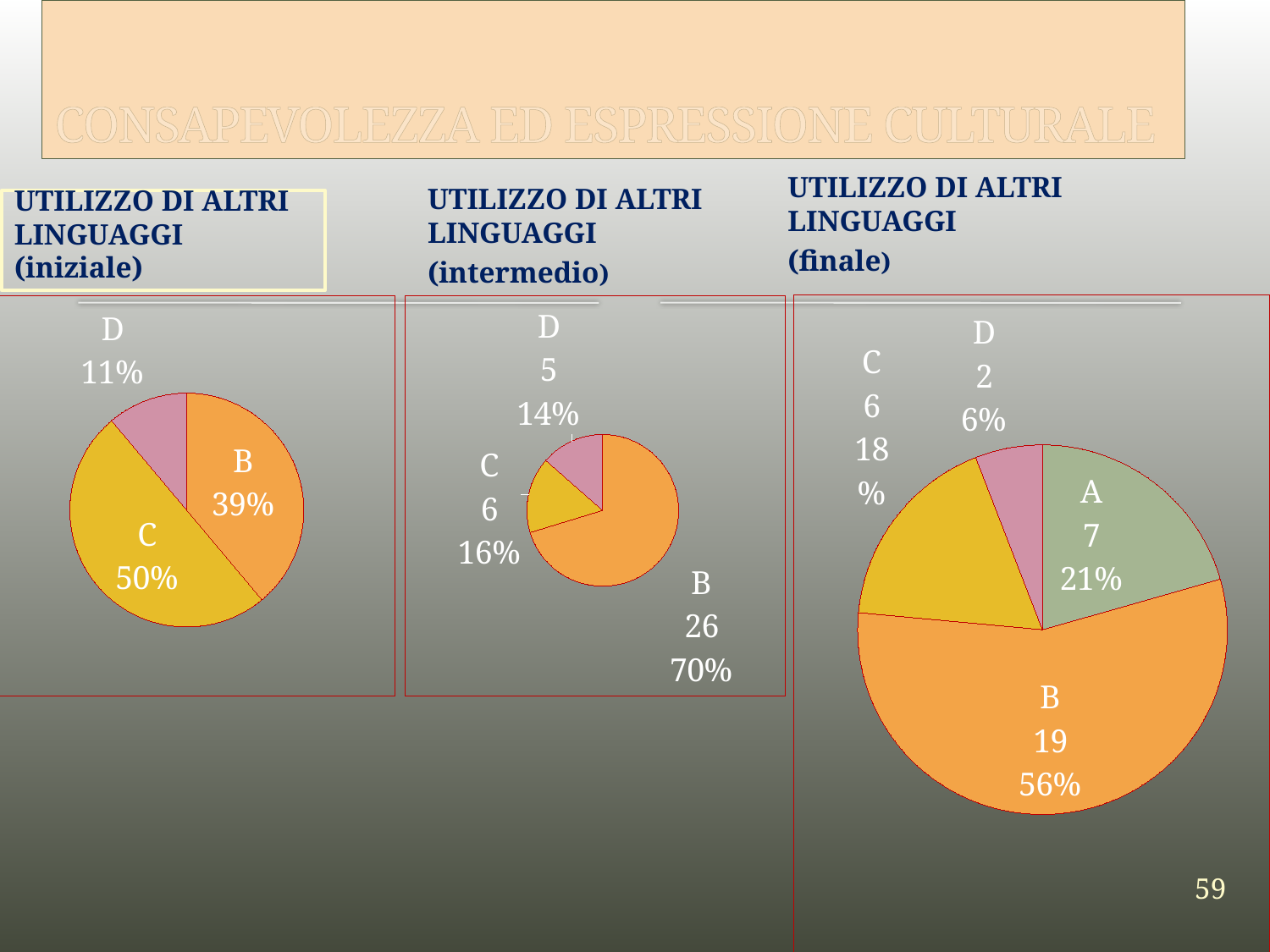
How many slices does the 'UTILIZZO DI ALTRI LINGUAGGI (finale)' pie chart have? 4 In the 'UTILIZZO DI ALTRI LINGUAGGI (iniziale)' chart, what share does slice C have? 50% In the 'UTILIZZO DI ALTRI LINGUAGGI (intermedio)' chart, what share does slice D have? 14% In the 'UTILIZZO DI ALTRI LINGUAGGI (intermedio)' chart, what is the value for B? 26 In the 'UTILIZZO DI ALTRI LINGUAGGI (intermedio)' chart, what is the difference between the values for B and C? 20 What kind of chart is used for 'UTILIZZO DI ALTRI LINGUAGGI (iniziale)'? pie chart How many slices does the 'UTILIZZO DI ALTRI LINGUAGGI (iniziale)' pie chart have? 3 In the 'UTILIZZO DI ALTRI LINGUAGGI (finale)' chart, which is larger, the value for C or the value for D? C In the 'UTILIZZO DI ALTRI LINGUAGGI (finale)' chart, what is the value for A? 7 In the 'UTILIZZO DI ALTRI LINGUAGGI (intermedio)' chart, which slice is the largest? B In the 'UTILIZZO DI ALTRI LINGUAGGI (finale)' chart, what share does slice B have? 56% In the 'UTILIZZO DI ALTRI LINGUAGGI (iniziale)' chart, which slice is the smallest? D